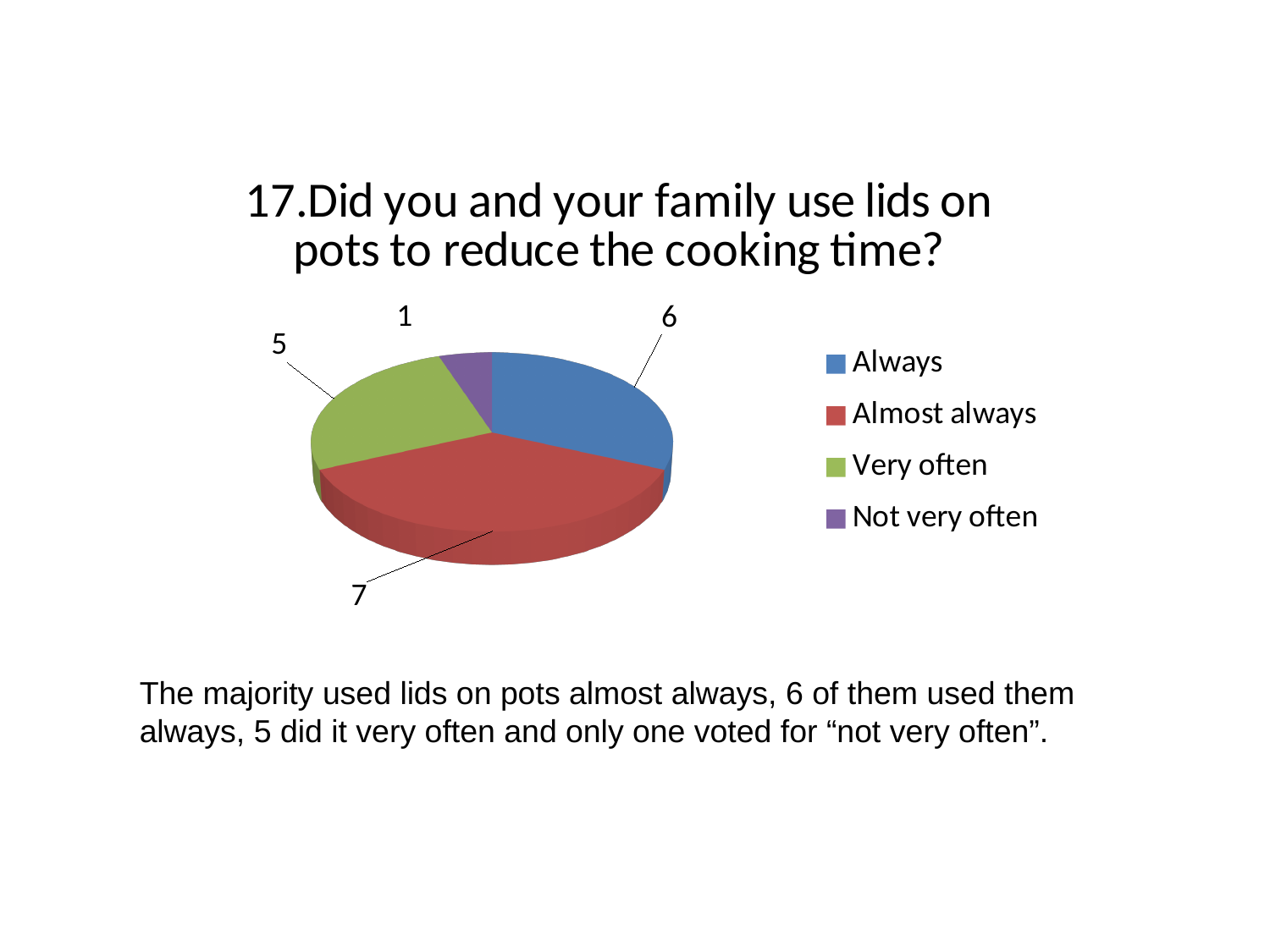
What colour is the "Very often" slice in the pie chart? Green What is the difference between the values for "Almost always" and "Very often"? 2 What is the total of all the values shown in the pie chart? 19 Which is larger, the value for "Always" or the value for "Very often"? Always What kind of chart is shown on the slide? Pie chart Which category has the largest slice of the pie? Almost always How many responses are shown for "Always"? 6 How many categories does the pie chart show? 4 How many responses are shown for "Almost always"? 7 Which category has the smallest slice of the pie? Not very often How many responses are shown for "Very often"? 5 How many responses are shown for "Not very often"? 1